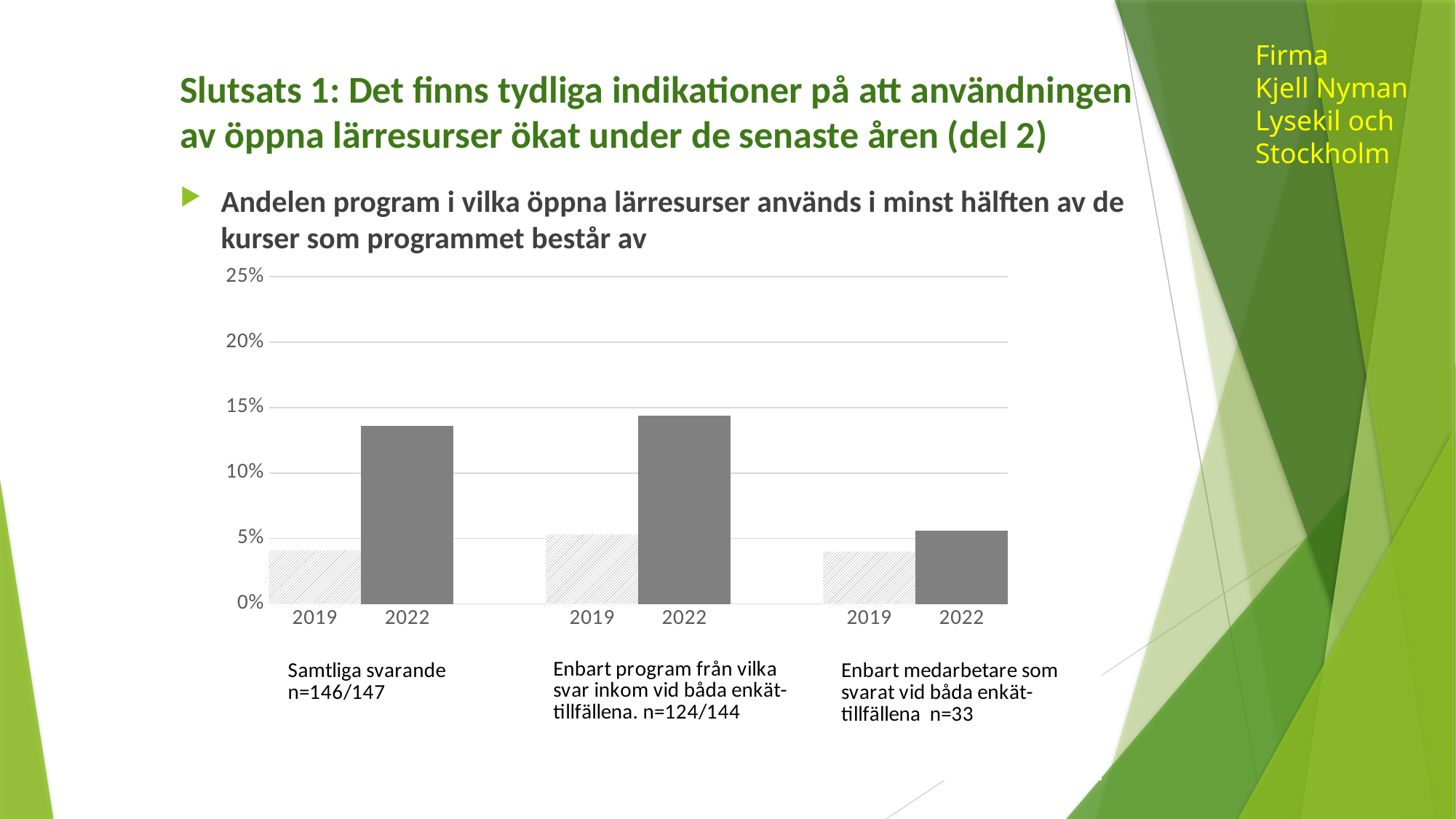
What kind of chart is shown on the slide? bar chart Is the 2022 value for 'Enbart medarbetare som svarat vid båda enkättillfällena' greater or less than 5%? greater Is the 2022 value for 'Samtliga svarande' greater or less than 10%? greater For 'Samtliga svarande', which year has the larger value, 2019 or 2022? 2022 Is the 2022 value for 'Enbart medarbetare som svarat vid båda enkättillfällena' greater or less than 10%? less How many bars are plotted in the chart? 6 How many groups of respondents are compared in the chart? 3 Which group has the highest 2022 value? Enbart program från vilka svar inkom vid båda enkättillfällena What is the highest value shown on the vertical axis? 25% Does the value rise or fall from 2019 to 2022 for 'Enbart medarbetare som svarat vid båda enkättillfällena'? rise